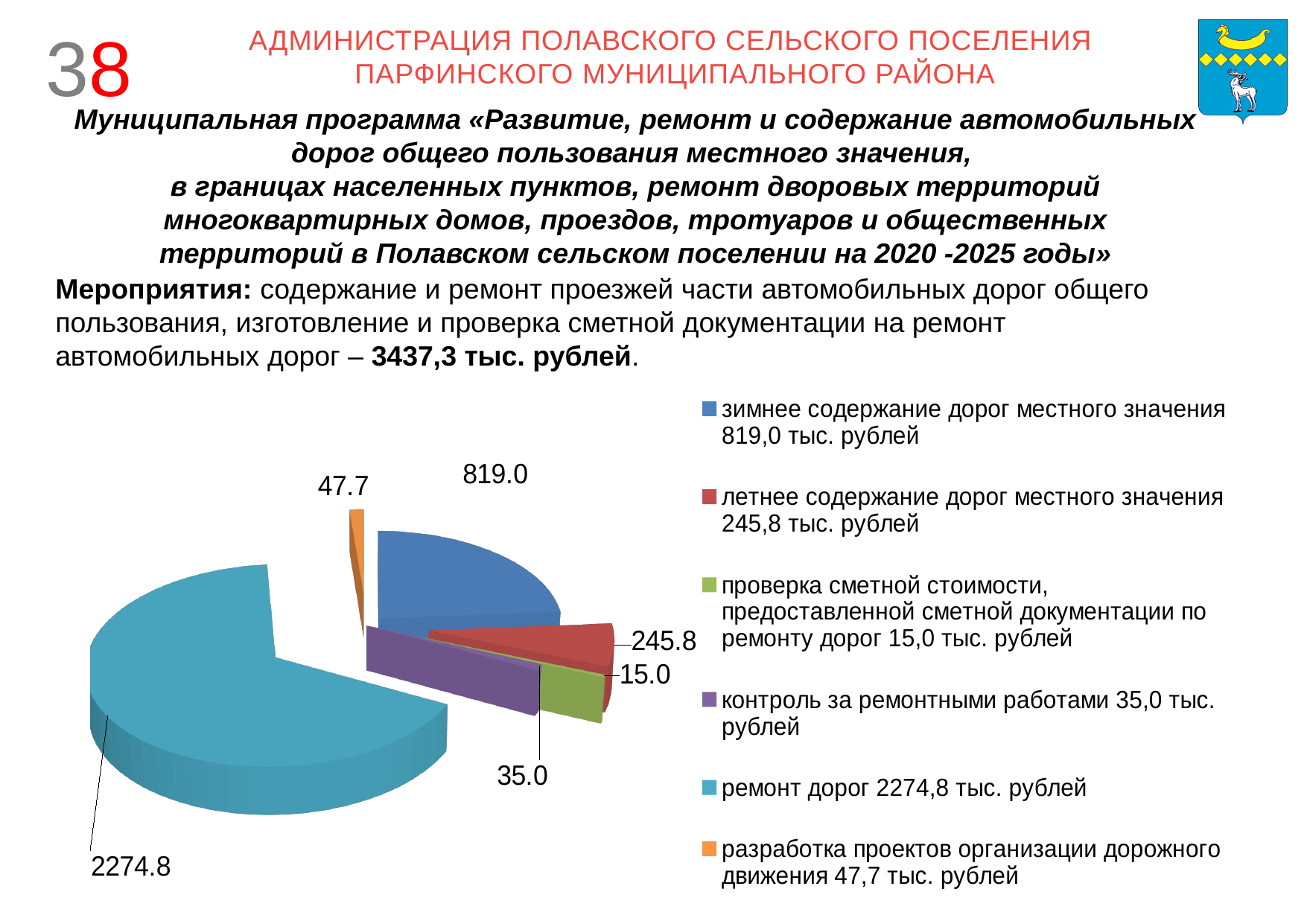
What is the value of the slice for разработка проектов организации дорожного движения? 47.7 What type of chart is shown on the slide? pie chart How many slices does the pie chart have? 6 Which category has the largest slice in the pie chart? ремонт дорог What colour is the slice for ремонт дорог? light blue (teal) Which is larger: the slice for летнее содержание дорог местного значения or the slice for разработка проектов организации дорожного движения? летнее содержание дорог местного значения What is the total of all slices in the pie chart, as stated on the slide? 3437,3 тыс. рублей What is the difference between the values for зимнее содержание дорог and летнее содержание дорог? 573.2 What is the value of the slice for контроль за ремонтными работами? 35.0 What is the value of the slice for зимнее содержание дорог местного значения? 819.0 Which category has the smallest slice in the pie chart? проверка сметной стоимости, предоставленной сметной документации по ремонту дорог What is the value of the slice for ремонт дорог? 2274.8